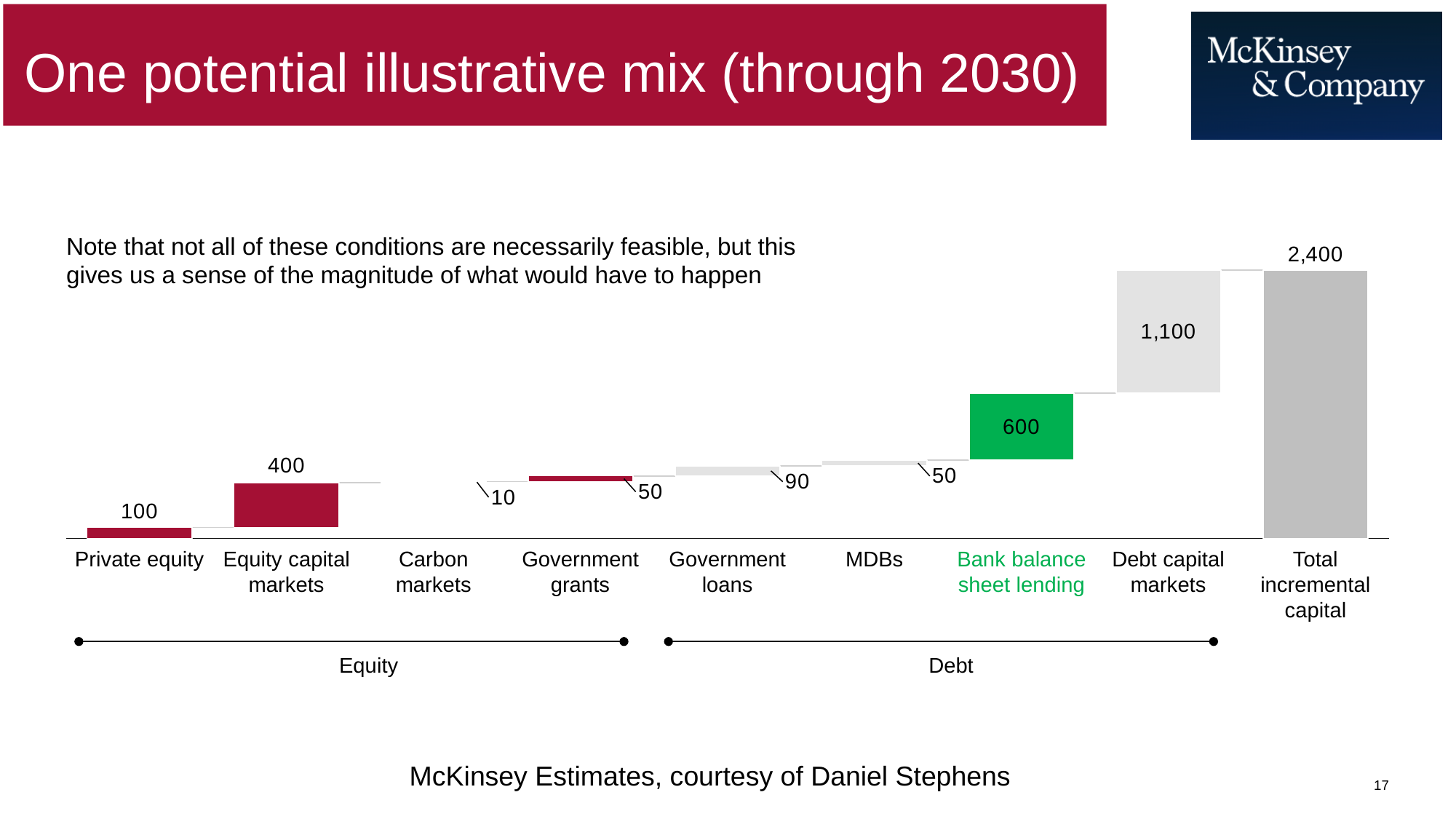
What is the difference between Debt capital markets and Bank balance sheet lending? 500 Which category label is shown in green text? Bank balance sheet lending Which category has the lowest value? Carbon markets What kind of chart is this? Waterfall bar chart What is the value shown for Total incremental capital? 2,400 Excluding the total bar, which category has the highest value? Debt capital markets How many categories are shown on the x axis, including the total? 9 What is the value for Bank balance sheet lending? 600 What is the value for Carbon markets? 10 What is the combined value of the four Equity categories (Private equity, Equity capital markets, Carbon markets, Government grants)? 560 What is the value for Equity capital markets? 400 Which is larger, Government loans or MDBs? Government loans